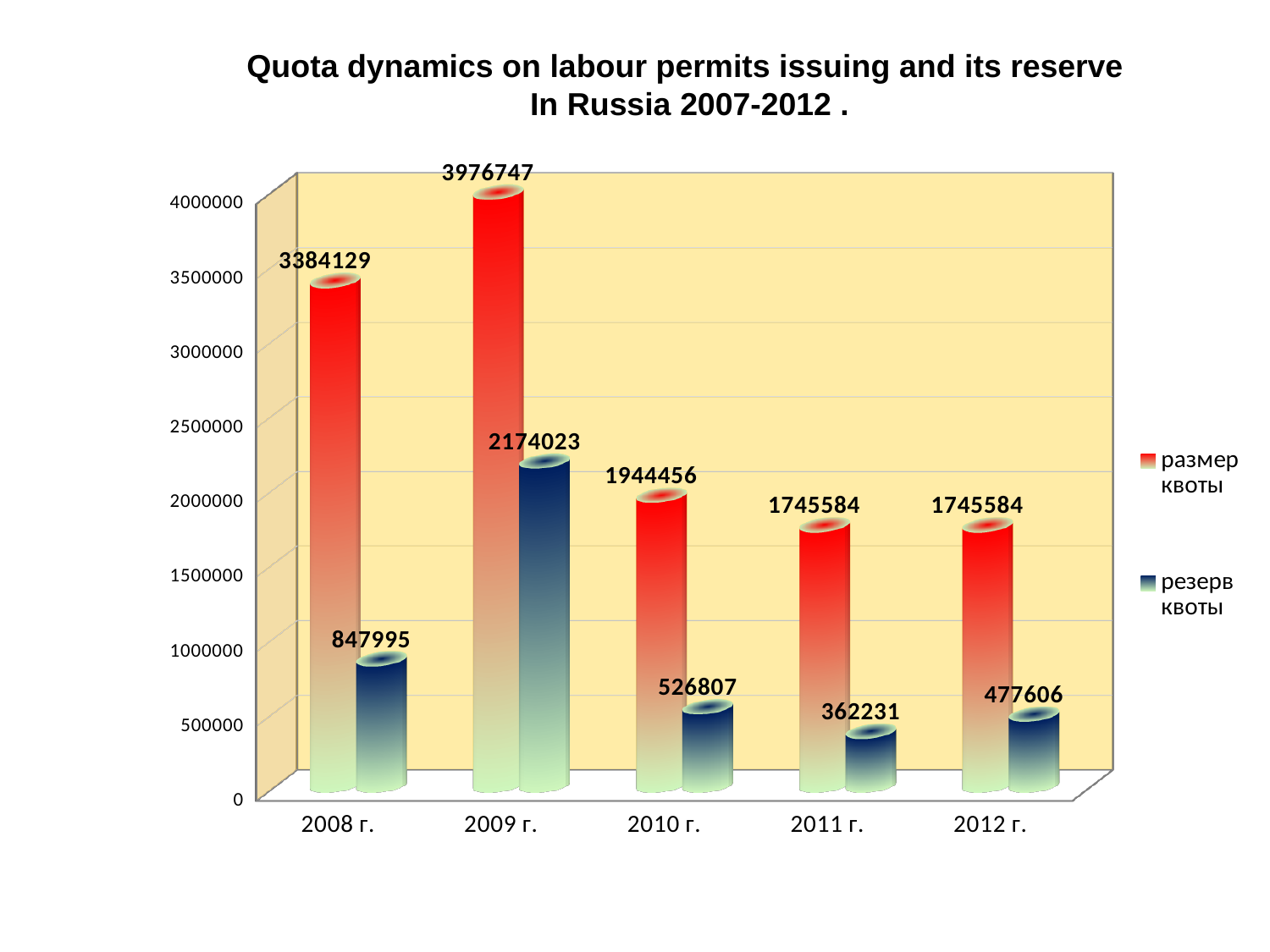
What is the value of резерв квоты for 2012 г.? 477606 Which is larger: резерв квоты in 2008 г. or резерв квоты in 2010 г.? 2008 г. How many years are shown on the x axis? 5 Is the value of размер квоты for 2010 г. greater or less than 2000000? less What is the value of размер квоты for 2009 г.? 3976747 What is the difference between размер квоты and резерв квоты in 2009 г.? 1802724 In which year is размер квоты highest? 2009 г. In which year is резерв квоты lowest? 2011 г. How many series does the legend list? 2 What kind of chart is shown on the slide? bar chart What is the difference between резерв квоты in 2012 г. and 2011 г.? 115375 What is the value of резерв квоты for 2008 г.? 847995